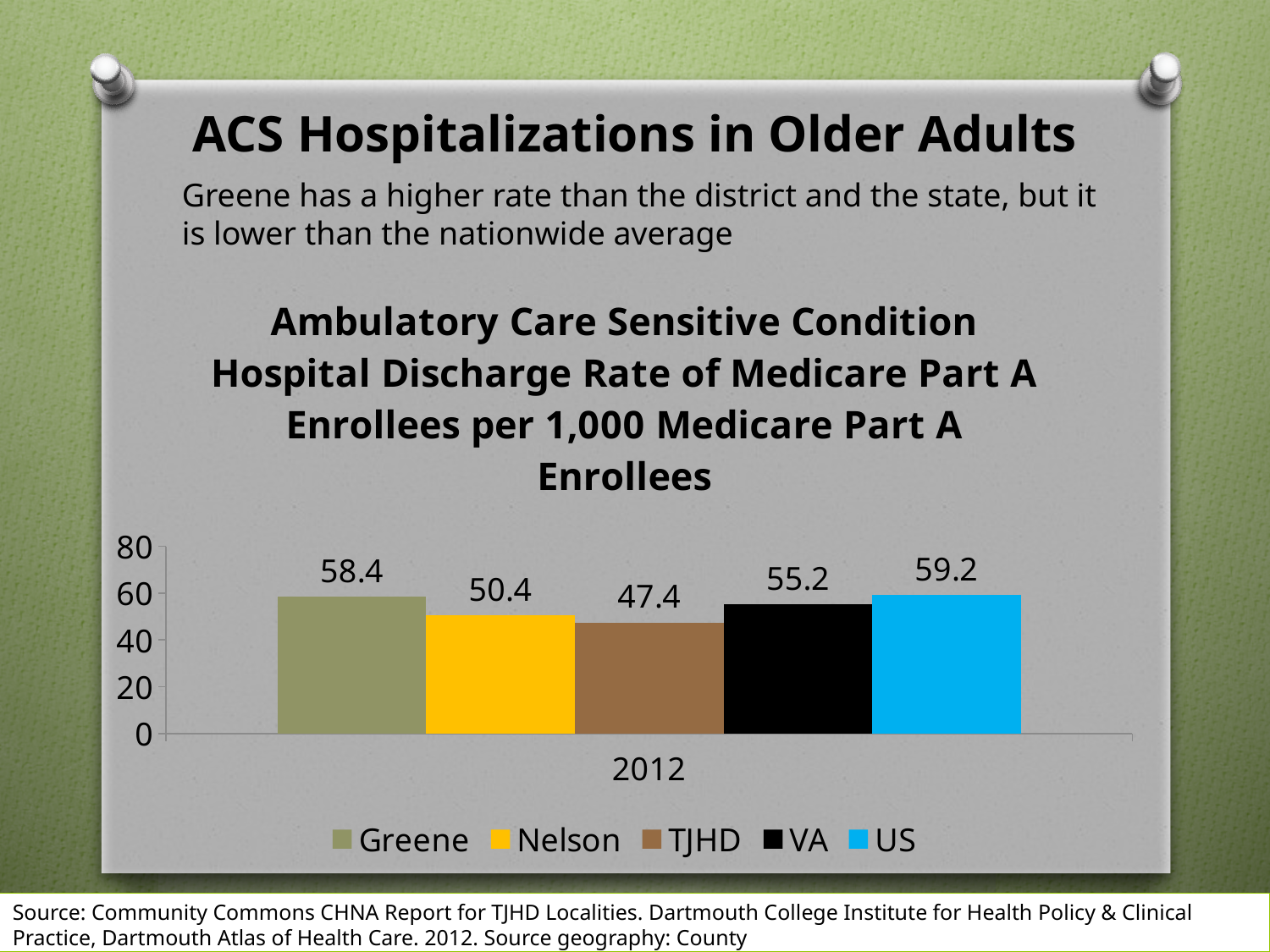
How many series does the legend list? 5 Is the value for Nelson greater or less than 60? less What is the value for TJHD in 2012? 47.4 What kind of chart is shown on the slide? bar chart What is the difference between the US value and the Greene value? 0.8 Which series has the lowest value in 2012? TJHD What is the difference between the Nelson value and the TJHD value? 3 What is the value for Greene in 2012? 58.4 Which is larger, the value for Greene or the value for VA? Greene What is the value for VA in 2012? 55.2 What colour is the bar for US? light blue Which series has the highest value in 2012? US